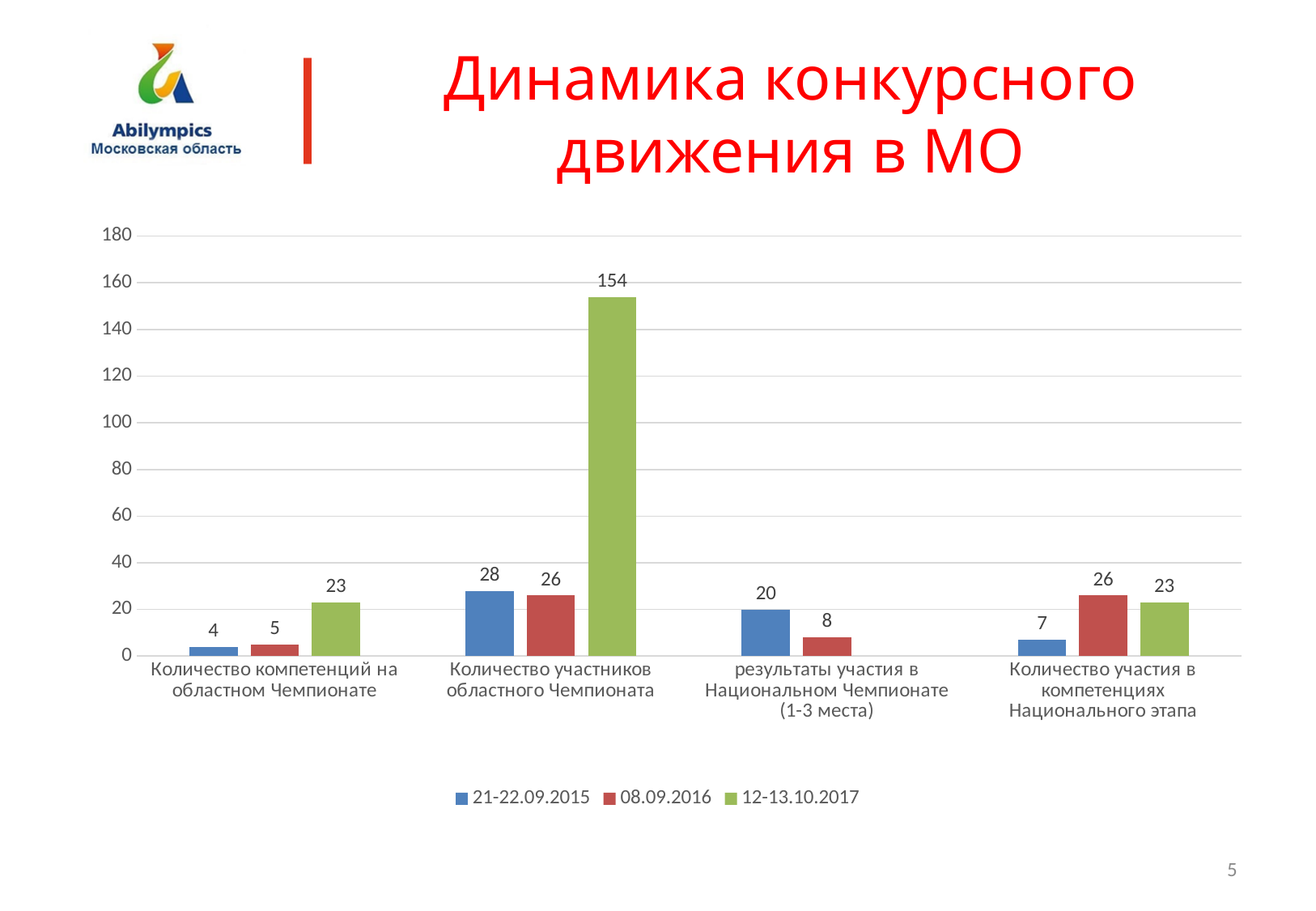
Which category has the lowest value in the 21-22.09.2015 series? Количество компетенций на областном Чемпионате What is the value for 'Количество участия в компетенциях Национального этапа' in the 12-13.10.2017 series? 23 What is the value for 'результаты участия в Национальном Чемпионате (1-3 места)' in the 08.09.2016 series? 8 What kind of chart is shown on the slide? Bar chart What is the difference between the 12-13.10.2017 and 08.09.2016 values for 'Количество участников областного Чемпионата'? 128 What is the value for 'Количество компетенций на областном Чемпионате' in the 21-22.09.2015 series? 4 What is the value for 'Количество участников областного Чемпионата' in the 12-13.10.2017 series? 154 Which is larger for 'Количество участия в компетенциях Национального этапа': the 08.09.2016 value or the 21-22.09.2015 value? 08.09.2016 Which category has the highest value in the 12-13.10.2017 series? Количество участников областного Чемпионата How many categories are shown on the x axis? 4 What is the title of the slide? Динамика конкурсного движения в МО How many series does the legend list? 3